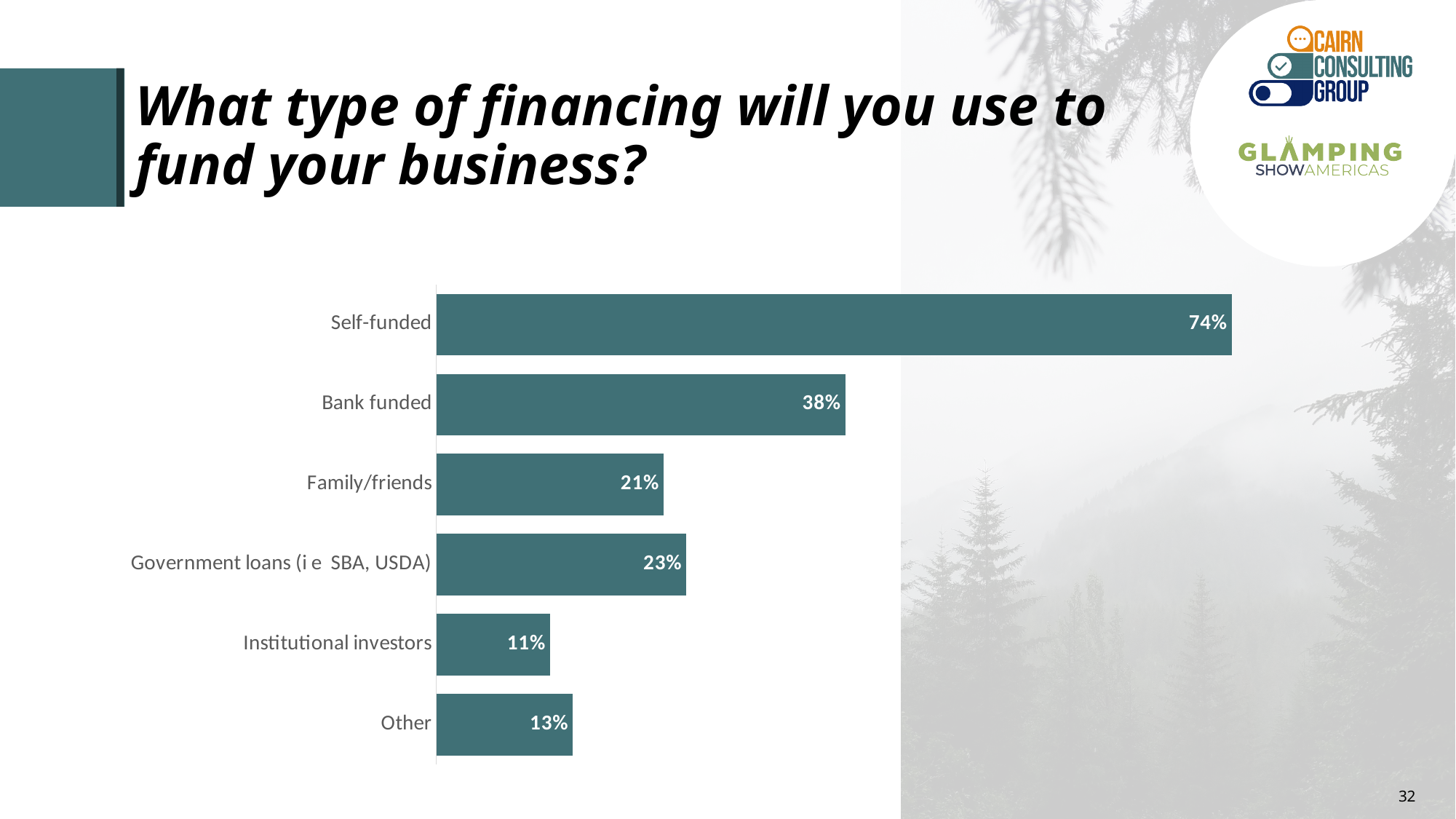
Which financing type has the lowest percentage? Institutional investors What kind of chart is shown on the slide? Bar chart What percentage is shown for Institutional investors? 11% What is the difference in percentage points between Self-funded and Bank funded? 36 What is the title of the slide containing the chart? What type of financing will you use to fund your business? Which financing type has the highest percentage? Self-funded What is the value for Government loans (i e SBA, USDA)? 23% What percentage of respondents said they will use self-funding to fund their business? 74% Which is larger, the value for Other or the value for Institutional investors? Other What is the difference in percentage points between Government loans (i e SBA, USDA) and Family/friends? 2 How many financing categories are shown in the chart? 6 What is the value shown for Bank funded? 38%